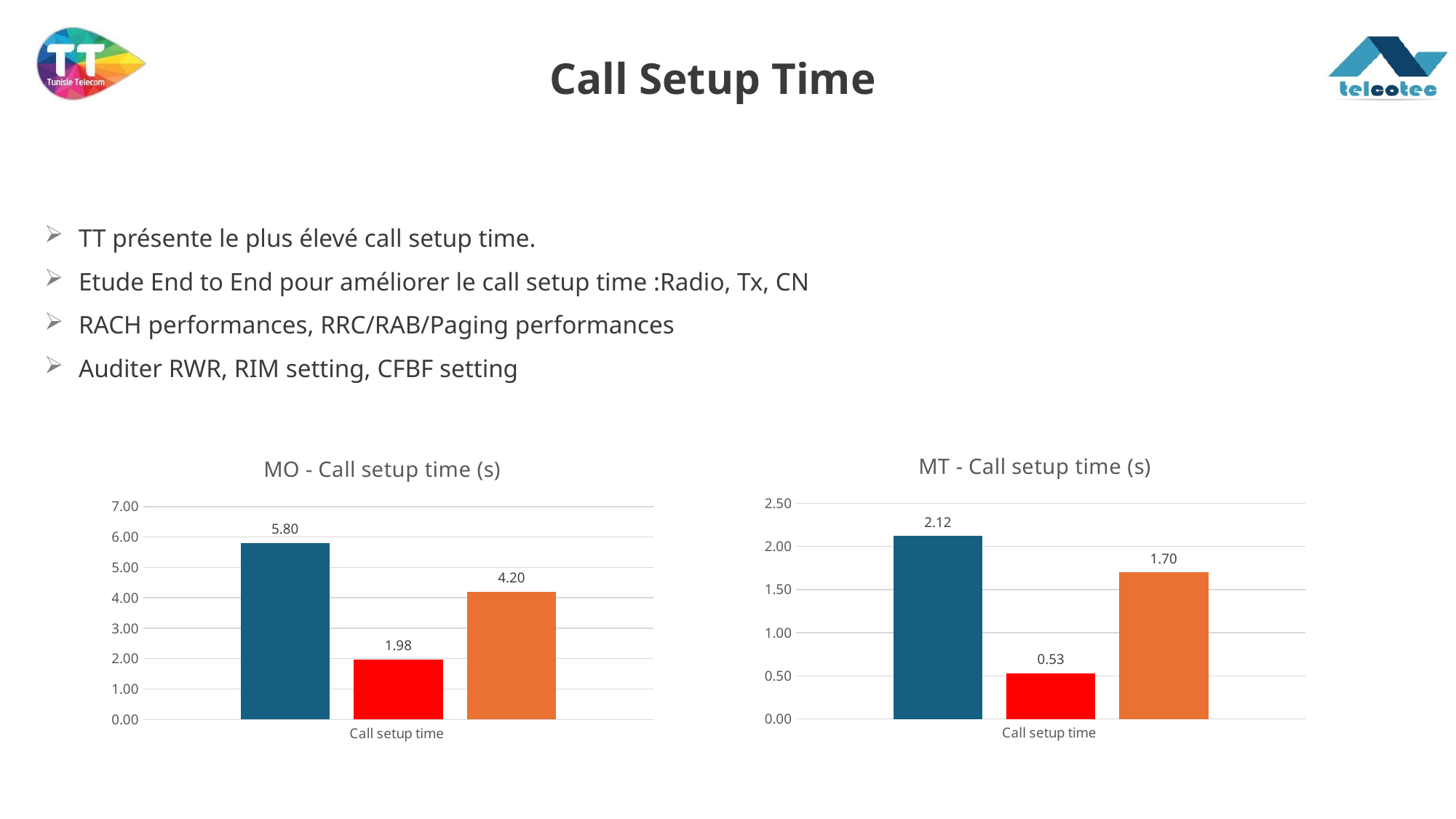
How many bars are plotted in the MT - Call setup time (s) chart? 3 In the MO - Call setup time (s) chart, is the value of the orange bar greater or less than 4.00? greater In the MT - Call setup time (s) chart, what is the value of the red bar? 0.53 In the MO - Call setup time (s) chart, what is the value of the red bar? 1.98 In the MT - Call setup time (s) chart, which is larger, the blue bar or the orange bar? blue bar In the MT - Call setup time (s) chart, what is the difference between the blue bar and the red bar? 1.59 What type of chart is the MO - Call setup time (s) chart? bar chart In the MO - Call setup time (s) chart, what is the value of the blue bar? 5.80 In the MT - Call setup time (s) chart, which coloured bar is the lowest? red In the MO - Call setup time (s) chart, what is the difference between the blue bar and the orange bar? 1.60 In the MO - Call setup time (s) chart, which coloured bar is the highest? blue In the MT - Call setup time (s) chart, what is the value of the orange bar? 1.70